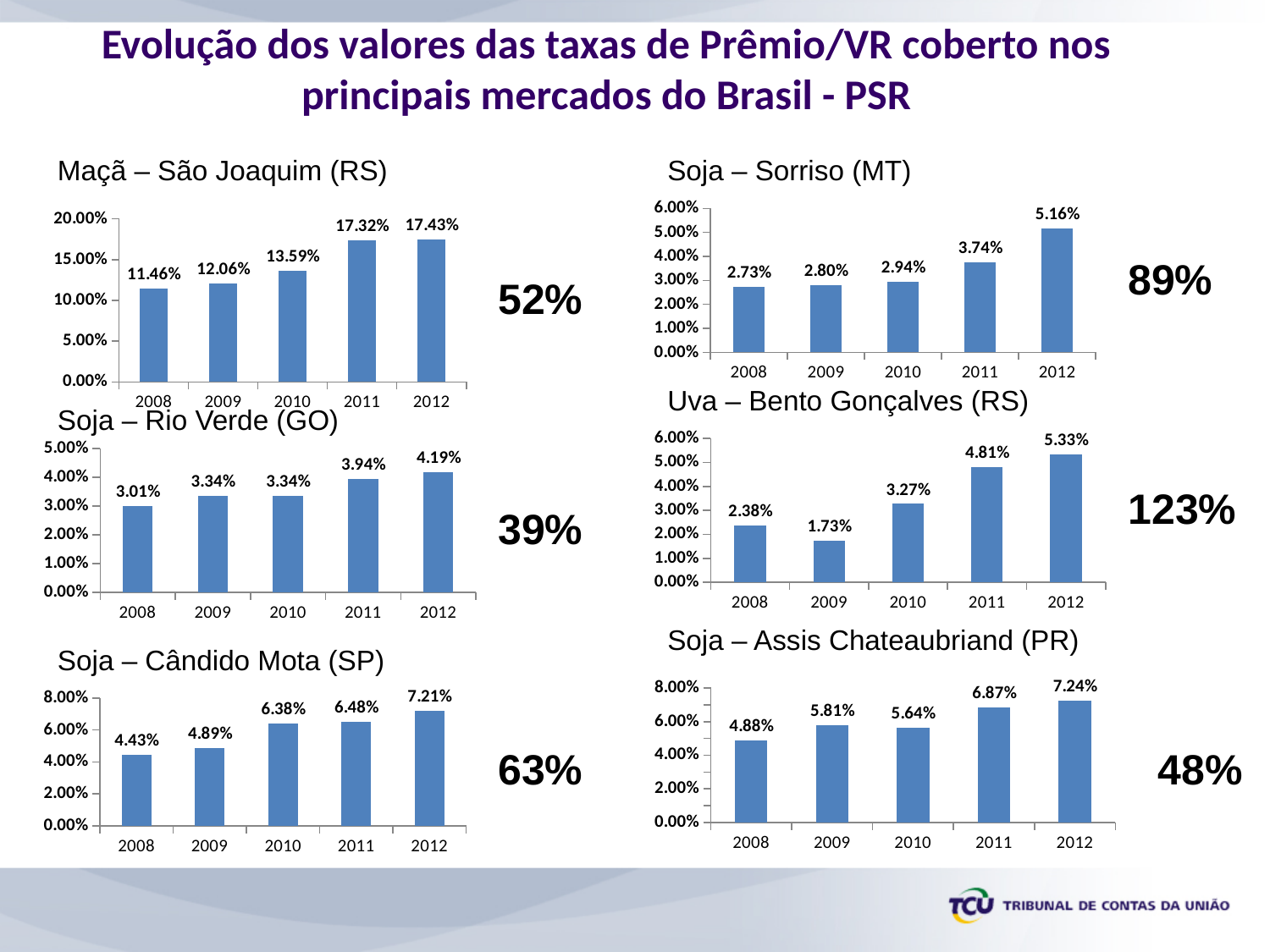
In the 'Soja – Cândido Mota (SP)' chart, what is the difference between the 2012 and 2008 values? 2.78% In the 'Soja – Assis Chateaubriand (PR)' chart, what is the value for 2009? 5.81% In the 'Soja – Assis Chateaubriand (PR)' chart, which year has the highest value? 2012 In the 'Soja – Sorriso (MT)' chart, what is the value for 2012? 5.16% In the 'Uva – Bento Gonçalves (RS)' chart, which year has the lowest value? 2009 In the 'Maçã – São Joaquim (RS)' chart, is the value for 2011 greater or less than 15.00%? greater In the 'Maçã – São Joaquim (RS)' chart, what is the value for 2010? 13.59% What kind of chart is 'Uva – Bento Gonçalves (RS)'? Bar chart What percentage is printed next to the 'Uva – Bento Gonçalves (RS)' chart? 123% In the 'Soja – Rio Verde (GO)' chart, which is larger, the value for 2011 or the value for 2008? 2011 How many years are shown on the x axis of the 'Soja – Sorriso (MT)' chart? 5 In the 'Soja – Cândido Mota (SP)' chart, do the values rise or fall from 2008 to 2012? Rise